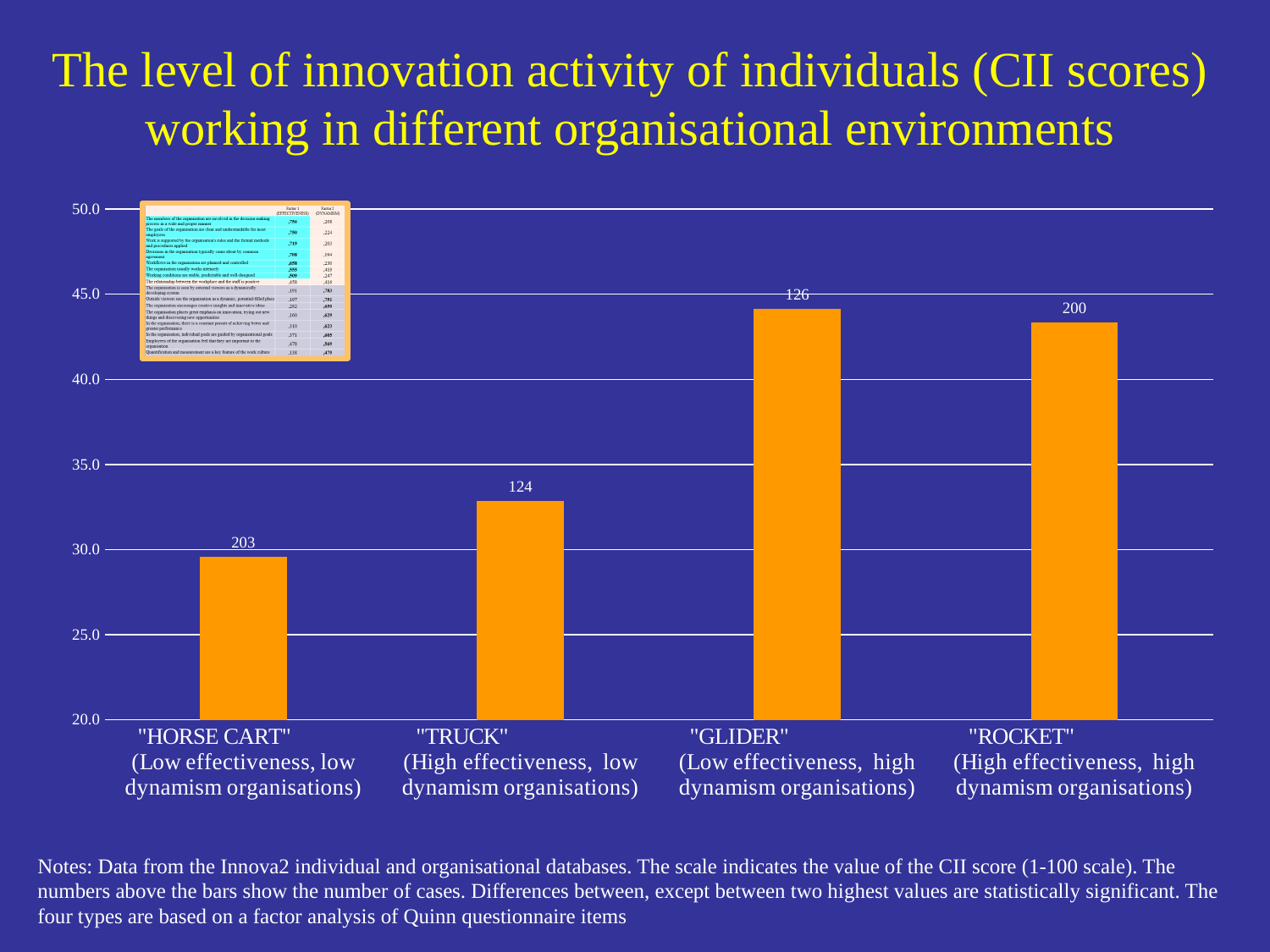
What number of cases is printed above the "GLIDER" bar? 126 Is the CII score for "TRUCK" greater or less than 30.0? greater What number of cases is printed above the "HORSE CART" bar? 203 What kind of chart is shown on the slide? bar chart Is the CII score for "HORSE CART" greater or less than 30.0? less How many organisational environment types (categories) are shown on the x axis? 4 Which organisational environment has the lowest CII score bar? "HORSE CART" Which organisational environment has the highest CII score bar? "GLIDER" Is the CII score for "ROCKET" greater or less than 40.0? greater What is the lowest value shown on the y axis of the chart? 20.0 Which has the larger CII score, "TRUCK" or "HORSE CART"? "TRUCK"